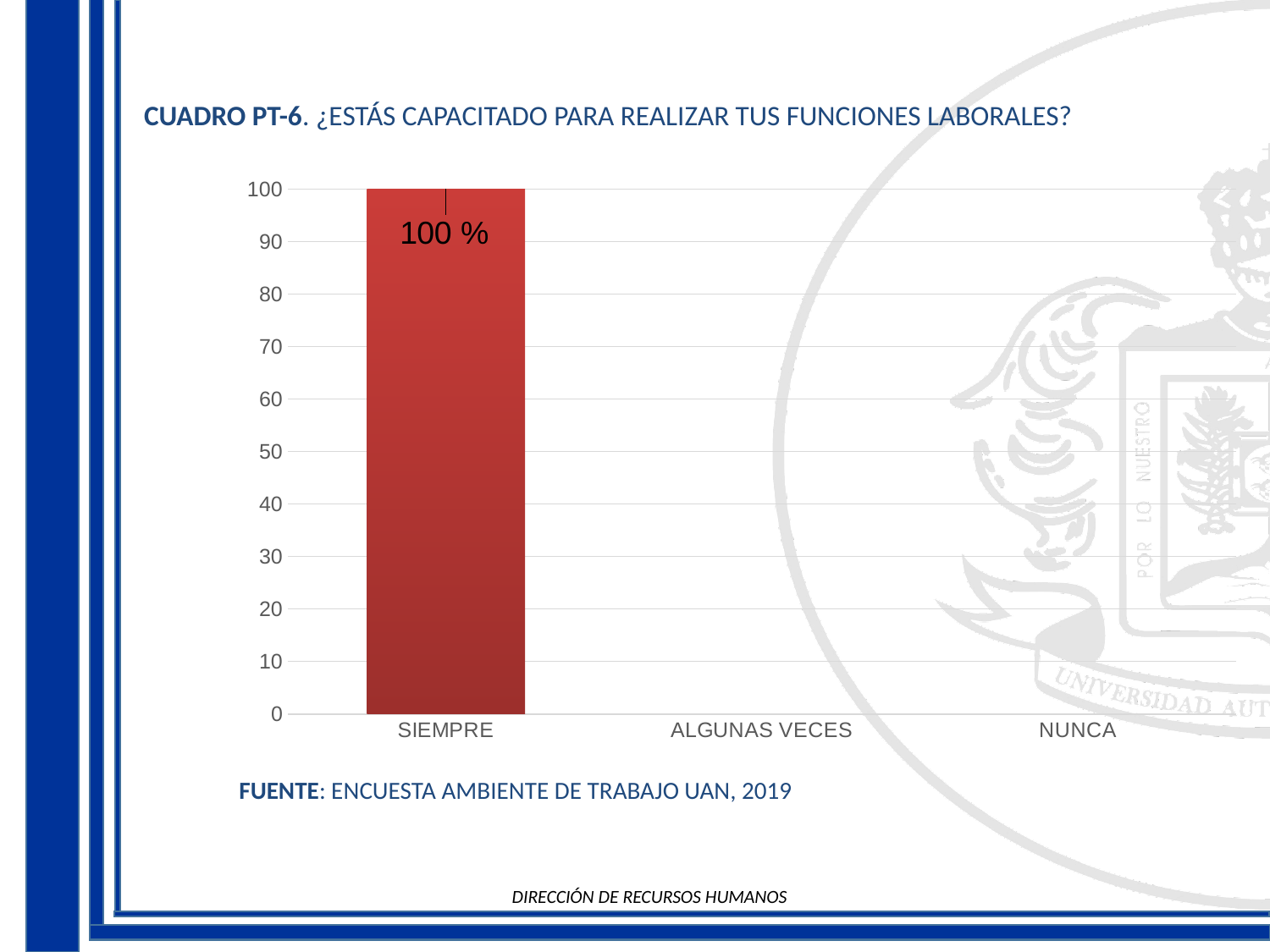
Is the value for SIEMPRE greater or less than 90? greater Which is larger, the value for SIEMPRE or the value for NUNCA? SIEMPRE Which is larger, the value for SIEMPRE or the value for ALGUNAS VECES? SIEMPRE Which category has the highest value? SIEMPRE What is the highest value shown on the vertical axis? 100 What value is shown for SIEMPRE? 100 % What kind of chart is shown on the slide? bar chart What colour is the bar for SIEMPRE? red How many categories are shown on the x axis? 3